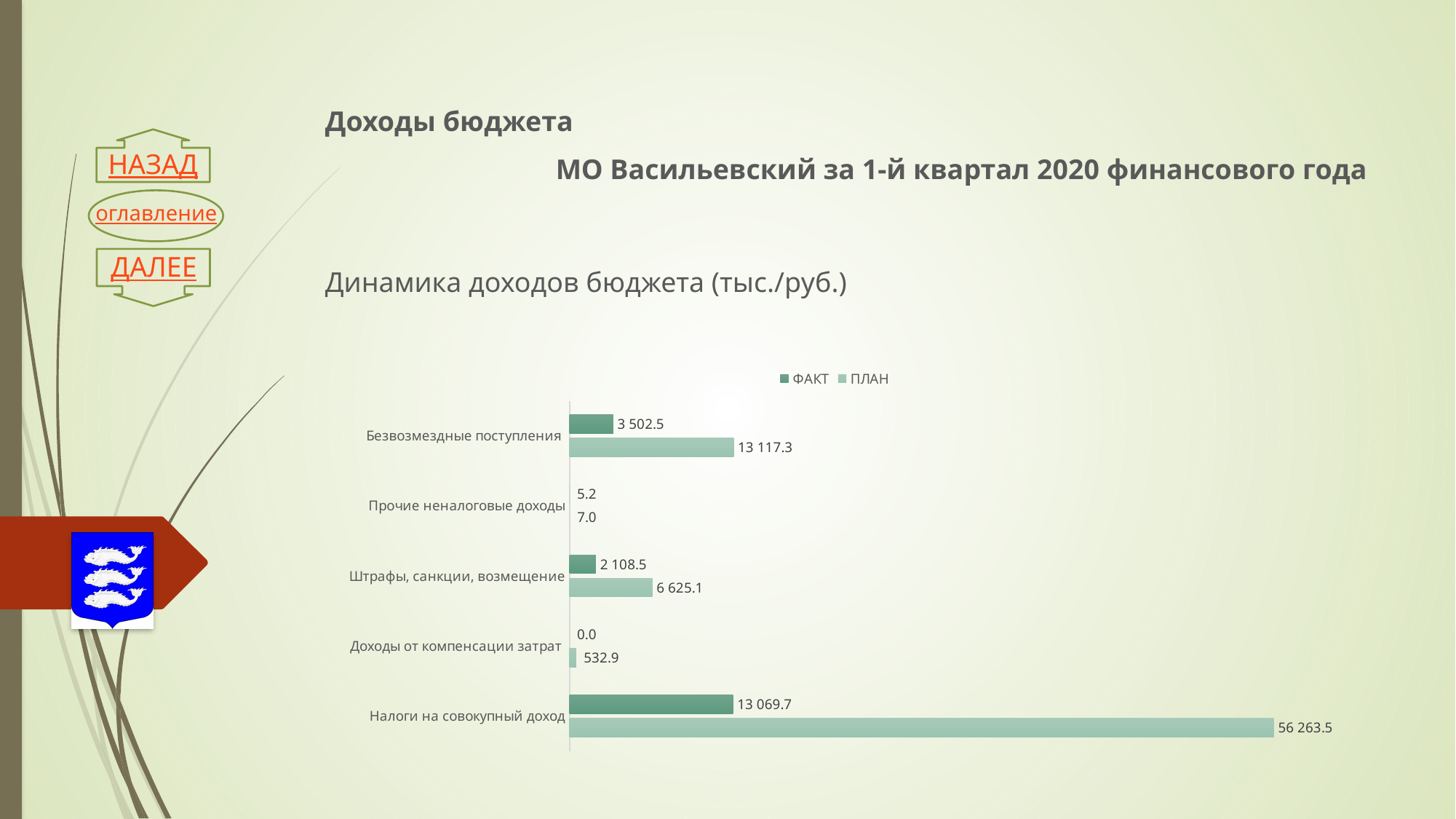
What is the ПЛАН value for Безвозмездные поступления? 13 117.3 How many series does the legend list? 2 Which category has the highest ПЛАН value? Налоги на совокупный доход What is the ФАКТ value for Налоги на совокупный доход? 13 069.7 Which category has the lowest ФАКТ value? Доходы от компенсации затрат What is the ПЛАН value for Доходы от компенсации затрат? 532.9 Which is larger for Безвозмездные поступления: the ФАКТ value or the ПЛАН value? ПЛАН What is the ФАКТ value for Штрафы, санкции, возмещение? 2 108.5 How many categories are shown in the chart? 5 What is the difference between the ПЛАН and ФАКТ values for Штрафы, санкции, возмещение? 4 516.6 What kind of chart is shown on the slide? Bar chart What is the difference between the ПЛАН and ФАКТ values for Налоги на совокупный доход? 43 193.8